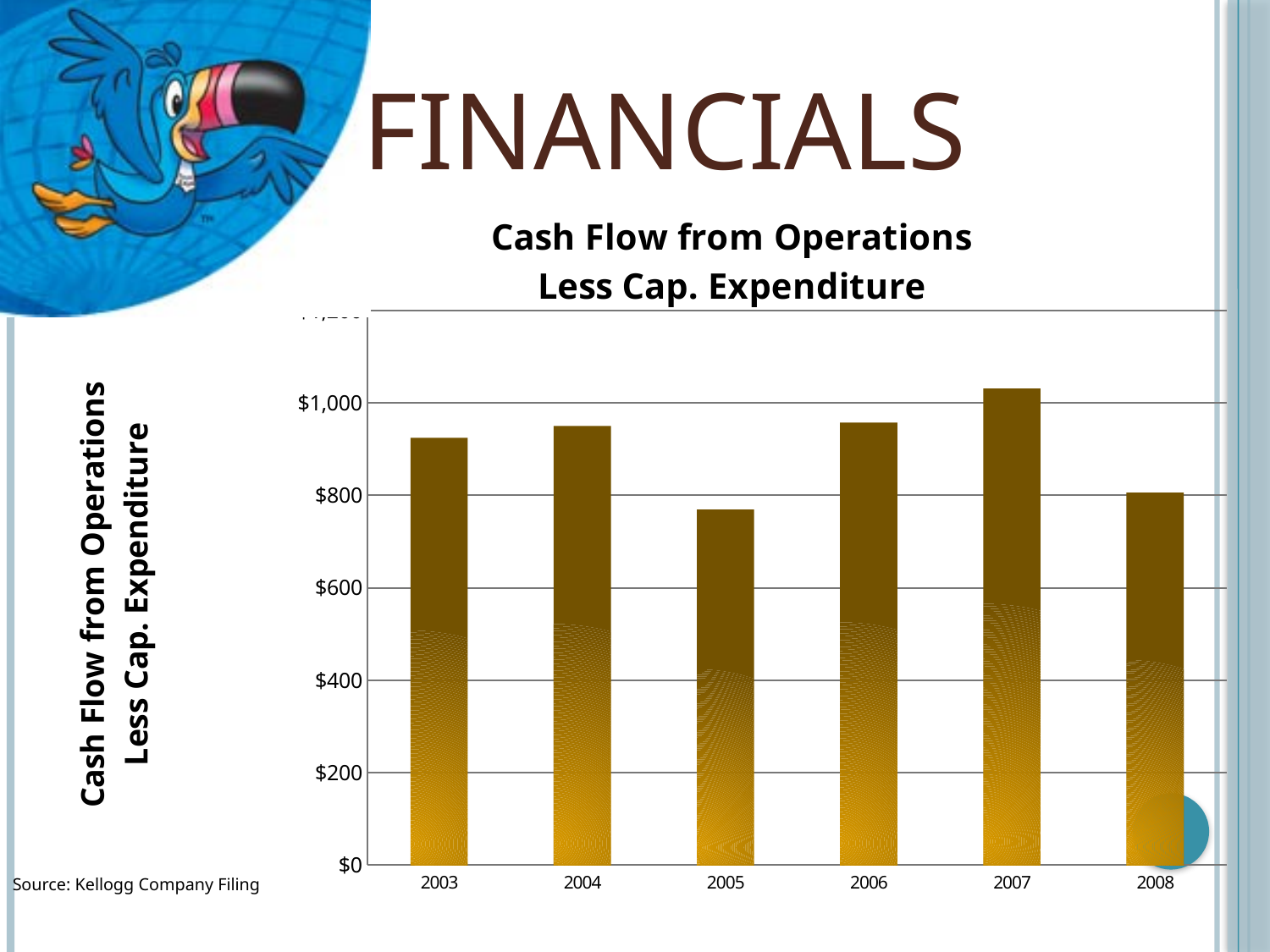
How many years are shown on the x axis of the chart? 6 What kind of chart is shown on the slide? bar chart Which year has the larger value, 2007 or 2008? 2007 Is the value for 2006 greater or less than $1,000? less Is the value for 2005 greater or less than $800? less Does the value rise or fall from 2007 to 2008? fall Which year has the highest cash flow from operations less cap. expenditure? 2007 Which year has the lowest cash flow from operations less cap. expenditure? 2005 Is the value for 2007 greater or less than $1,000? greater Which year has the larger value, 2005 or 2006? 2006 What is the title of the chart? Cash Flow from Operations Less Cap. Expenditure